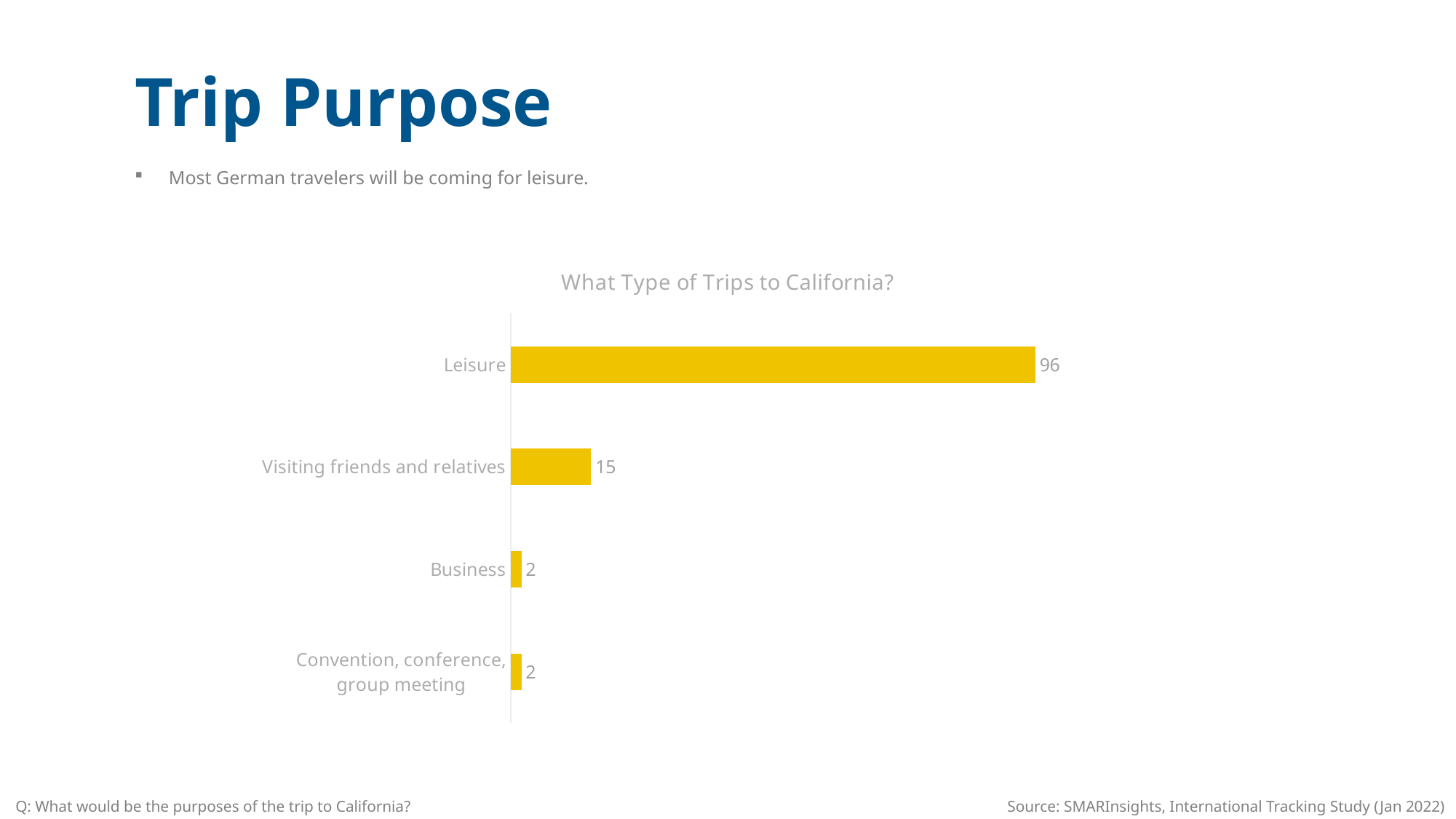
What is the value for Leisure? 96 What is the title of the chart? What Type of Trips to California? What is the value for Visiting friends and relatives? 15 What is the value for Business? 2 How many categories are shown in the chart? 4 Which category has the highest value? Leisure What kind of chart is shown on the slide? Bar chart What is the difference between the values for Visiting friends and relatives and Business? 13 Which is larger, the value for Leisure or the value for Visiting friends and relatives? Leisure What colour are the bars in the chart? Yellow What is the value for Convention, conference, group meeting? 2 What is the difference between the values for Leisure and Visiting friends and relatives? 81